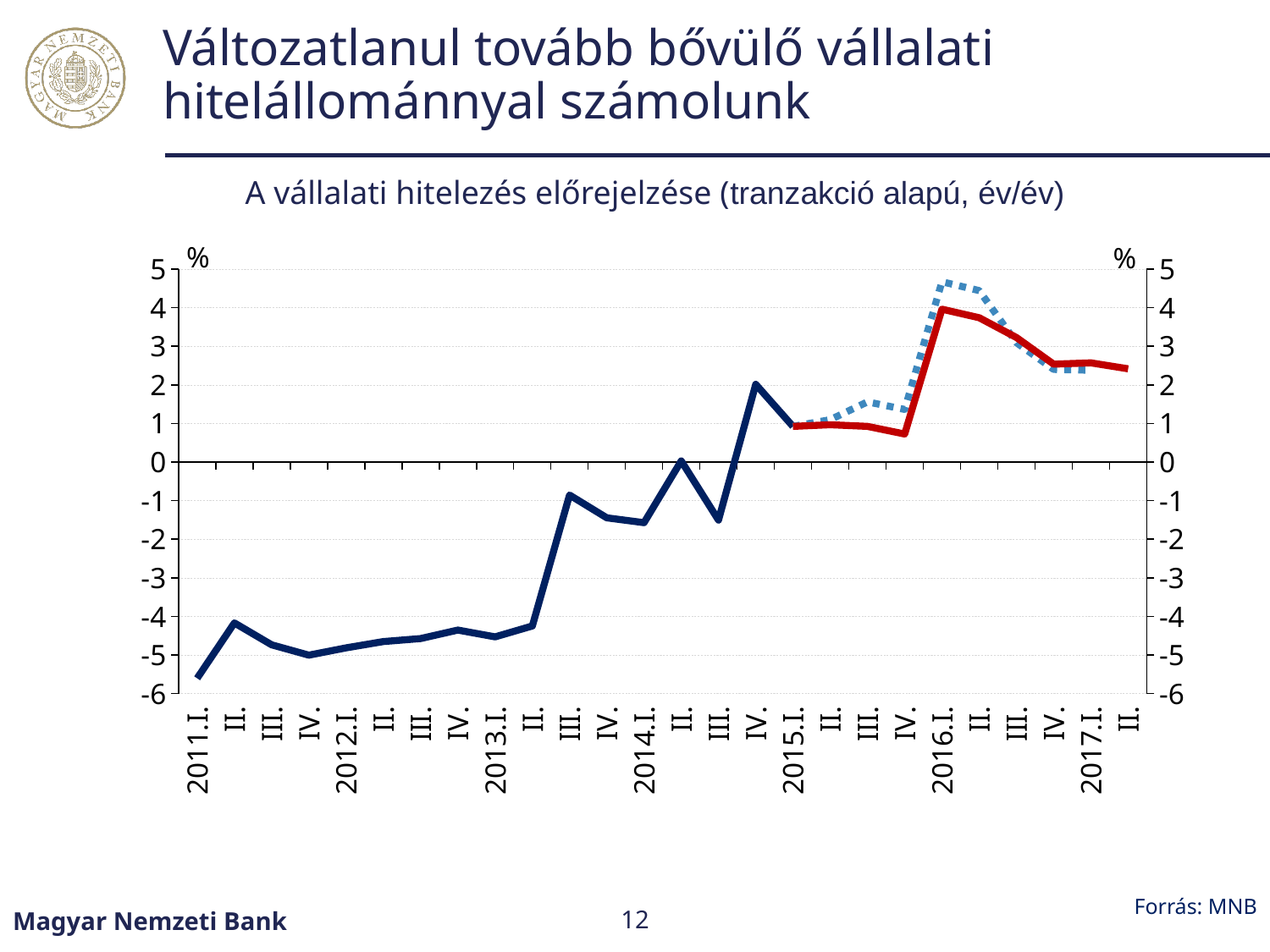
What kind of chart is shown on the slide? line chart Is the value for 2011.I. greater or less than -5? less Is the value of the solid red line for 2016.I. greater or less than 3? greater How many quarterly points are labelled along the x axis, from 2011.I. to 2017.II.? 26 Which is larger, the value for 2013.III. or the value for 2013.IV.? 2013.III. What unit is shown on the vertical axes of the chart? % Is the value of the dotted line for 2016.I. greater or less than 4? greater What is the title of the chart? A vállalati hitelezés előrejelzése (tranzakció alapú, év/év) Which quarter has the lowest value on the chart? 2011.I.